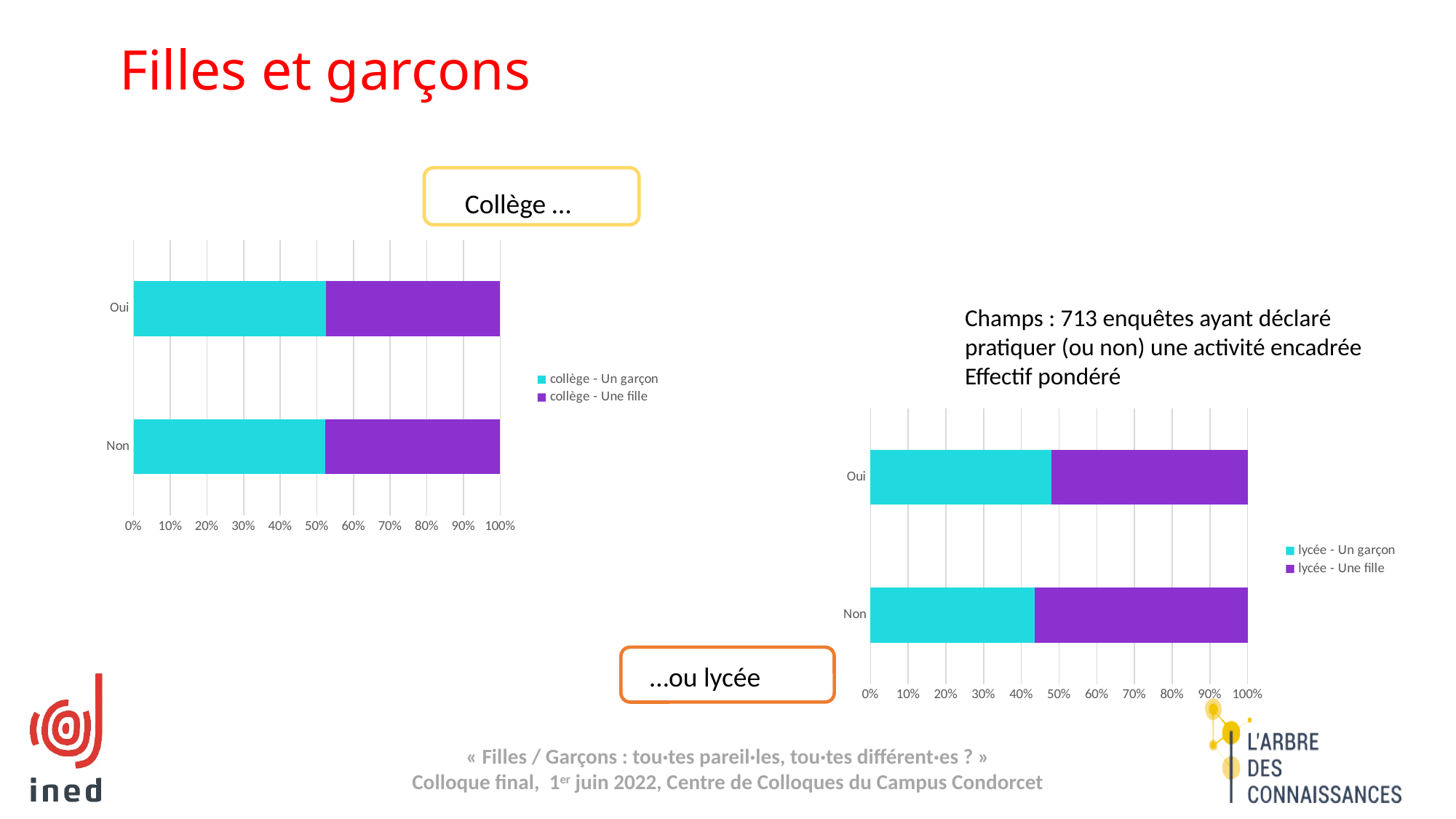
How many series does the legend of the right chart (lycée) list? 2 What is the maximum value shown on the x axis of the left chart (Collège)? 100% In the right chart (lycée), is the share of "lycée - Une fille" for "Non" greater or less than 50%? greater In the right chart (lycée), for the "Non" category, which series has the larger share: "lycée - Un garçon" or "lycée - Une fille"? lycée - Une fille In the right chart (lycée), which colour represents "lycée - Une fille"? purple What kind of chart is the left chart labelled "Collège ..."? stacked bar chart In the right chart (lycée), is the share of "lycée - Un garçon" for "Non" greater or less than 50%? less In the right chart (lycée), what is the total of the stacked bar for "Oui"? 100% What are the two legend entries of the left chart (Collège)? collège - Un garçon; collège - Une fille In the left chart (Collège), is the share of "collège - Une fille" for "Non" greater or less than 60%? less How many categories are shown on the y axis of the left chart (Collège)? 2